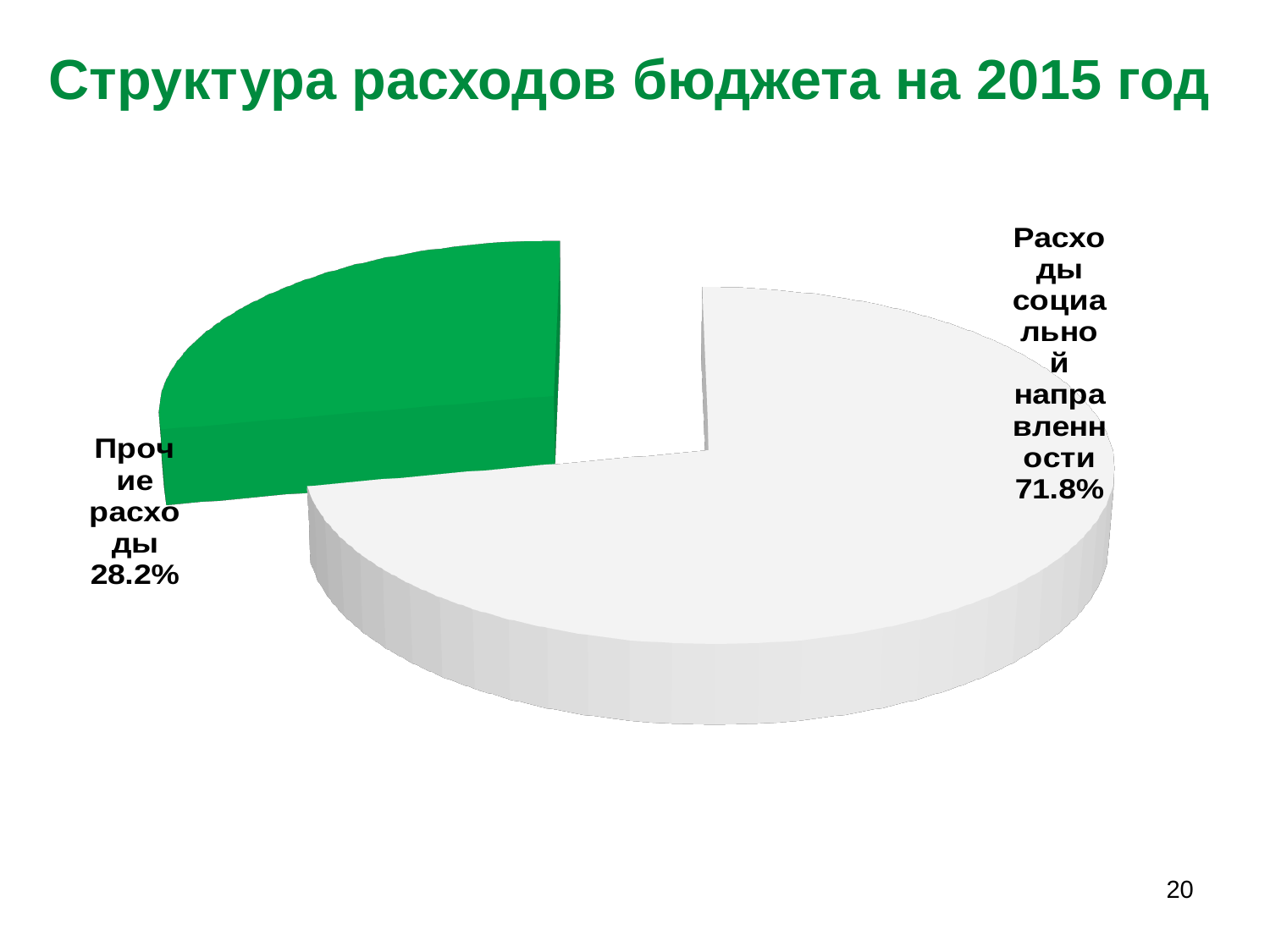
What kind of chart is shown on the slide? Pie chart What is the difference in percentage points between the "Расходы социальной направленности" slice and the "Прочие расходы" slice? 43.6 What share of the pie is labelled "Расходы социальной направленности"? 71.8% Which is larger: the "Прочие расходы" slice or the "Расходы социальной направленности" slice? Расходы социальной направленности What colour is the "Прочие расходы" slice? Green Which slice of the pie is the smallest? Прочие расходы What share of the pie is labelled "Прочие расходы"? 28.2% Which slice of the pie is the largest? Расходы социальной направленности How many slices does the pie chart have? 2 What is the title of the slide? Структура расходов бюджета на 2015 год